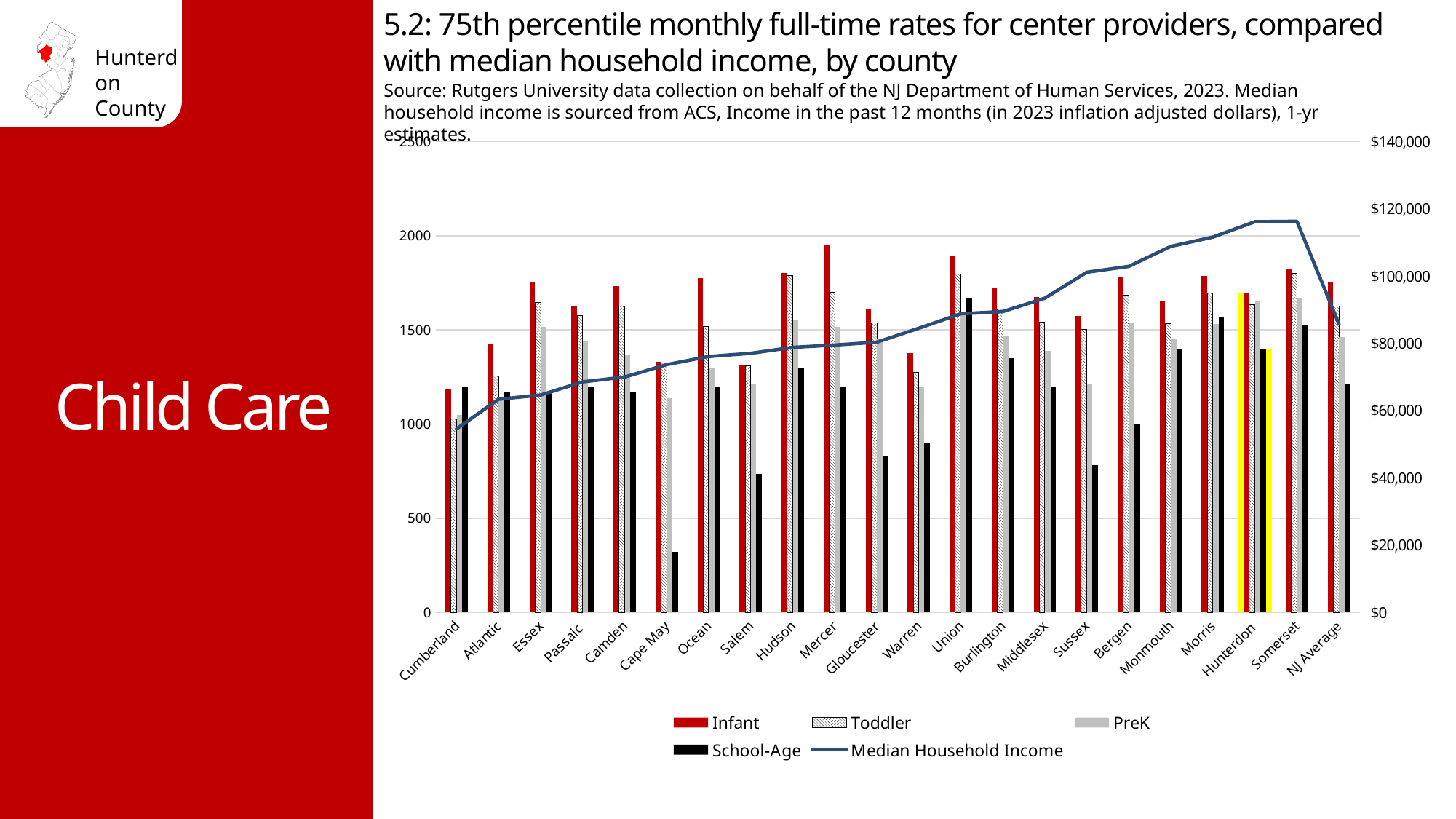
How many series does the legend list? 5 How many counties (including NJ Average) are shown on the x axis? 22 Is the Median Household Income for Somerset greater or less than $100,000? greater Which county has the highest Infant rate? Mercer Which county has the lowest Infant rate? Cumberland Does the Median Household Income line generally rise or fall from Cumberland to Somerset? rise Is the Infant rate for Cumberland greater or less than 1000? greater Which county has the lowest School-Age rate? Cape May Which county's bars are outlined in yellow on the chart? Hunterdon What kind of chart is shown on the slide? Bar chart with a line Which is larger, the Infant rate for Mercer or the Infant rate for Cumberland? Mercer Is the School-Age rate for Cape May greater or less than 500? less